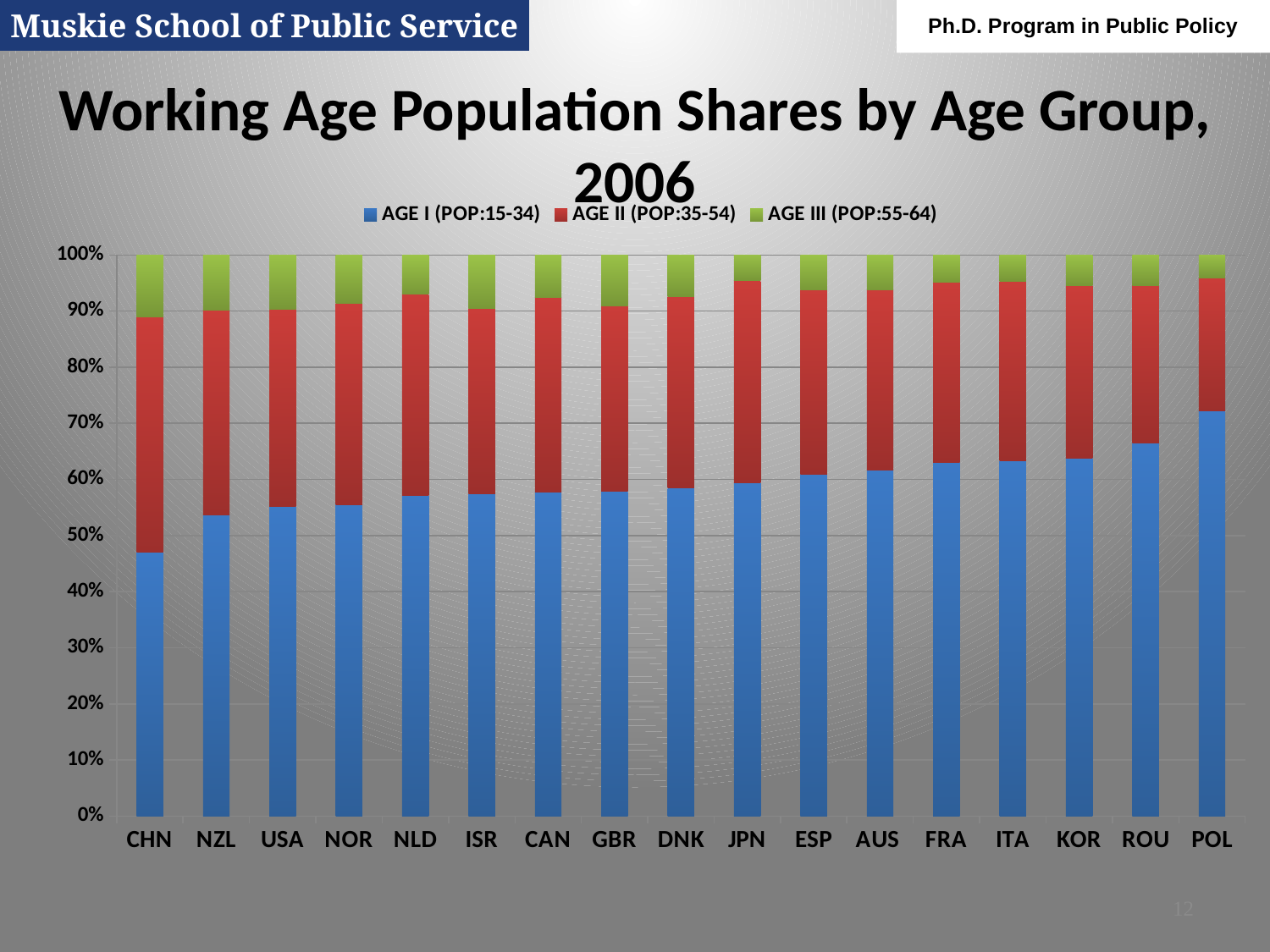
Which country has a larger AGE I (POP:15-34) share, POL or CHN? POL How many series does the chart legend list? 3 Is the AGE I (POP:15-34) share for ROU greater or less than 60%? greater Which country has the largest AGE III (POP:55-64) share? CHN Which country has the largest AGE I (POP:15-34) share? POL Is the AGE I (POP:15-34) share for CHN greater or less than 50%? less Does the AGE I (POP:15-34) share rise or fall moving from left to right along the x axis? rise How many countries are shown along the x axis of the chart? 17 Which age group does the blue series represent in the legend? AGE I (POP:15-34) Which country has the smallest AGE I (POP:15-34) share? CHN What is the title of the chart? Working Age Population Shares by Age Group, 2006 What kind of chart is shown on the slide? Stacked bar chart